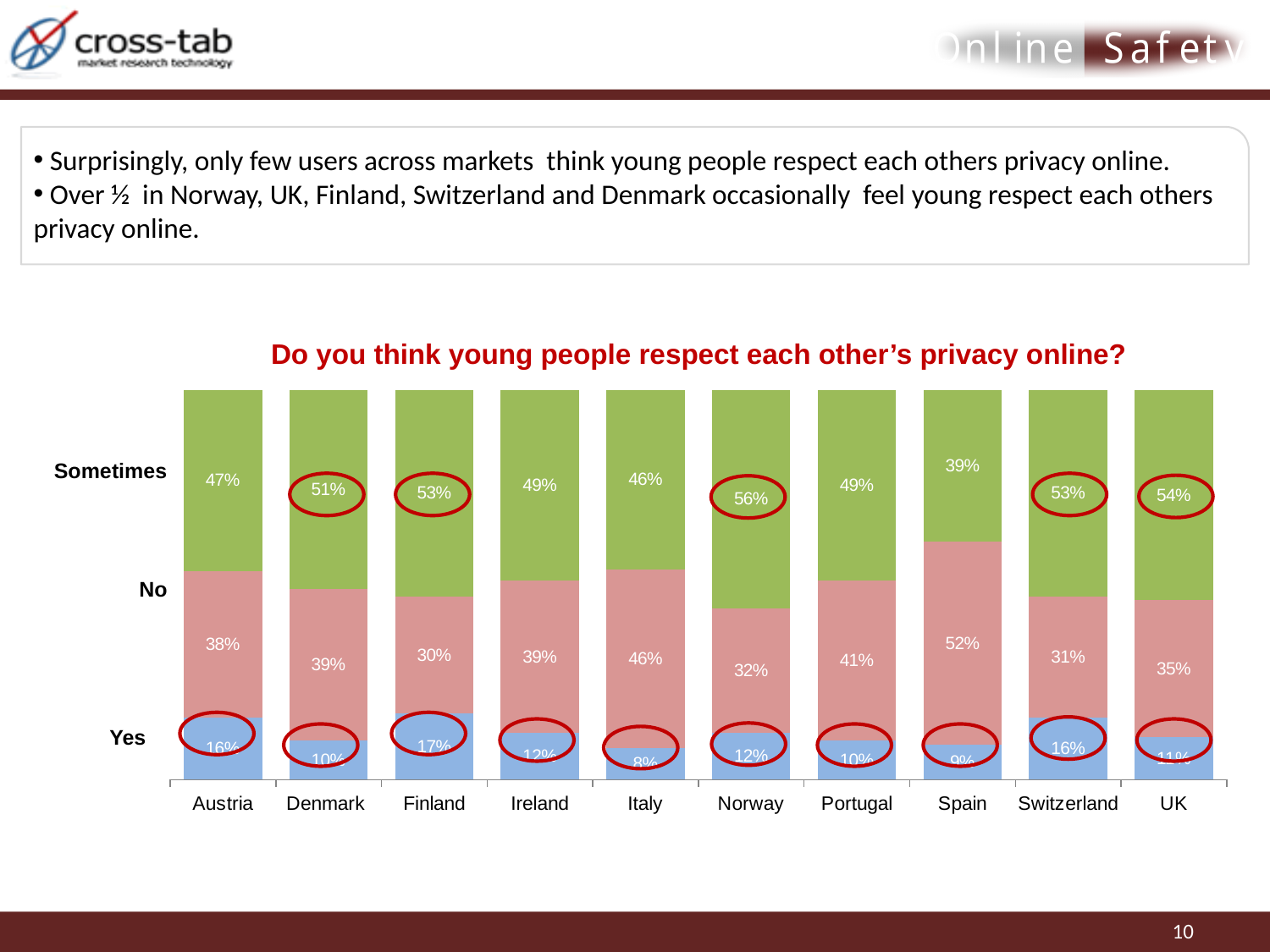
Which country has the highest 'No' percentage? Spain Which country has the highest 'Sometimes' percentage? Norway What type of chart is shown on the slide? Stacked bar chart What percentage of respondents in Norway answered 'Sometimes'? 56% How many countries are shown in the chart? 10 Which country has the lowest 'Sometimes' percentage? Spain What is the difference between the 'Sometimes' percentage for the UK and for Austria? 7 percentage points Which country has the lowest 'No' percentage? Finland What percentage of respondents in Finland answered 'Yes'? 17% Which has a higher 'No' percentage, Italy or Portugal? Italy What percentage of respondents in Spain answered 'No'? 52% How many response categories are stacked in each bar? 3